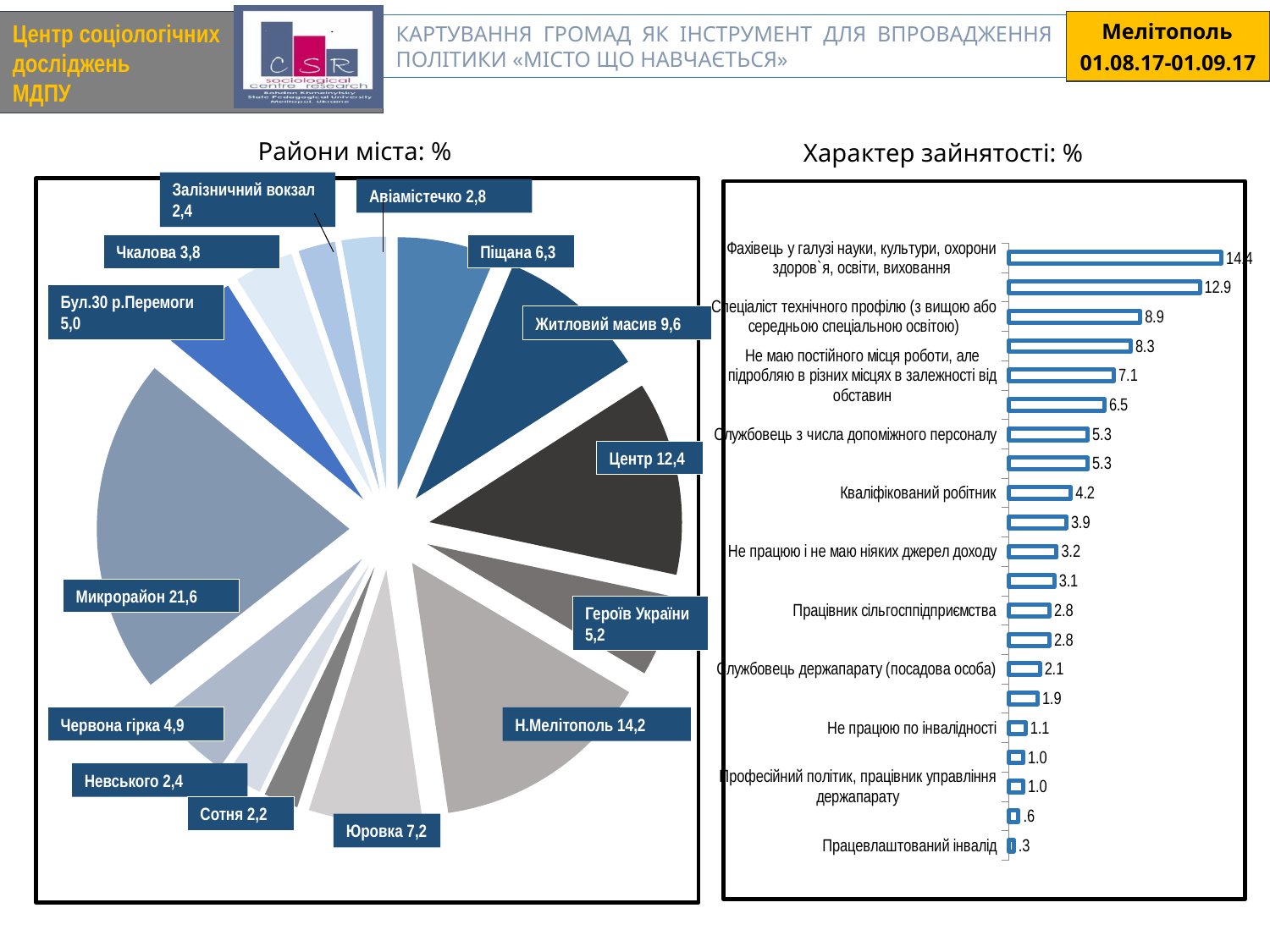
On the pie chart 'Райони міста: %', which district has the smallest share? Сотня On the pie chart 'Райони міста: %', which is larger: Центр or Житловий масив? Центр On the pie chart 'Райони міста: %', what is the difference between Микрорайон and Н.Мелітополь? 7,4 On the bar chart 'Характер зайнятості: %', what is the highest value shown? 14.4 On the pie chart 'Райони міста: %', what is the value for Юровка? 7,2 On the bar chart 'Характер зайнятості: %', what is the value for Кваліфікований робітник? 4.2 On the bar chart 'Характер зайнятості: %', what is the value for Працевлаштований інвалід? .3 On the pie chart 'Райони міста: %', how many districts (slices) are shown? 14 On the pie chart 'Райони міста: %', what is the value for Микрорайон? 21,6 On the pie chart 'Райони міста: %', which district has the largest share? Микрорайон What kind of chart is the right chart 'Характер зайнятості: %'? Bar chart What kind of chart is the left chart 'Райони міста: %'? Pie chart